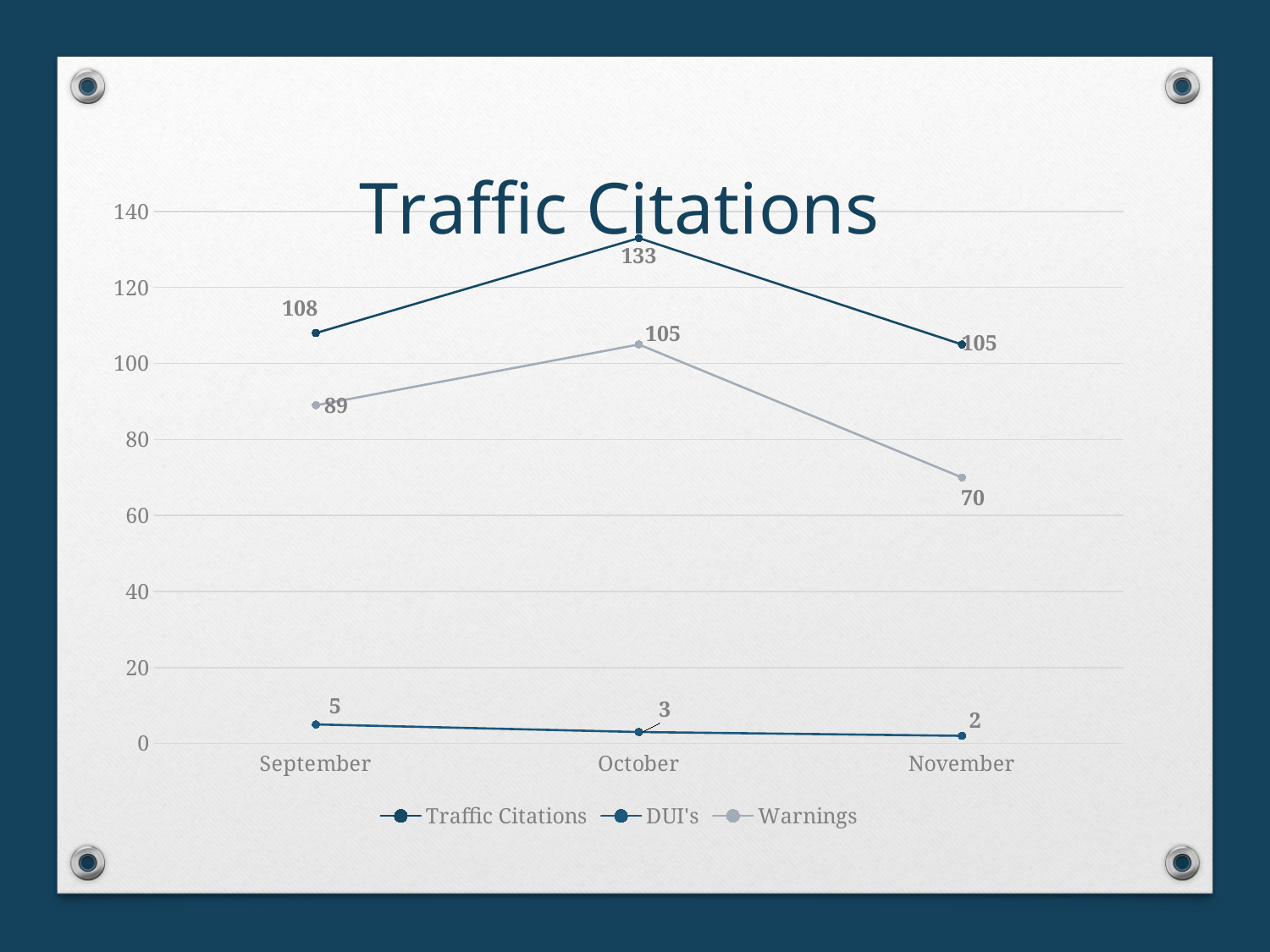
In which month are Warnings lowest? November How many series does the legend list? 3 What is the value for Warnings in November? 70 What is the title of the chart? Traffic Citations What is the value for Traffic Citations in October? 133 How many months are shown on the x axis? 3 In which month are Traffic Citations highest? October Do the DUI's values rise or fall from September to November? Fall What is the value for DUI's in September? 5 Which is larger: Warnings in September or Warnings in October? Warnings in October What kind of chart is shown on the slide? Line chart What is the difference between Traffic Citations in October and in November? 28